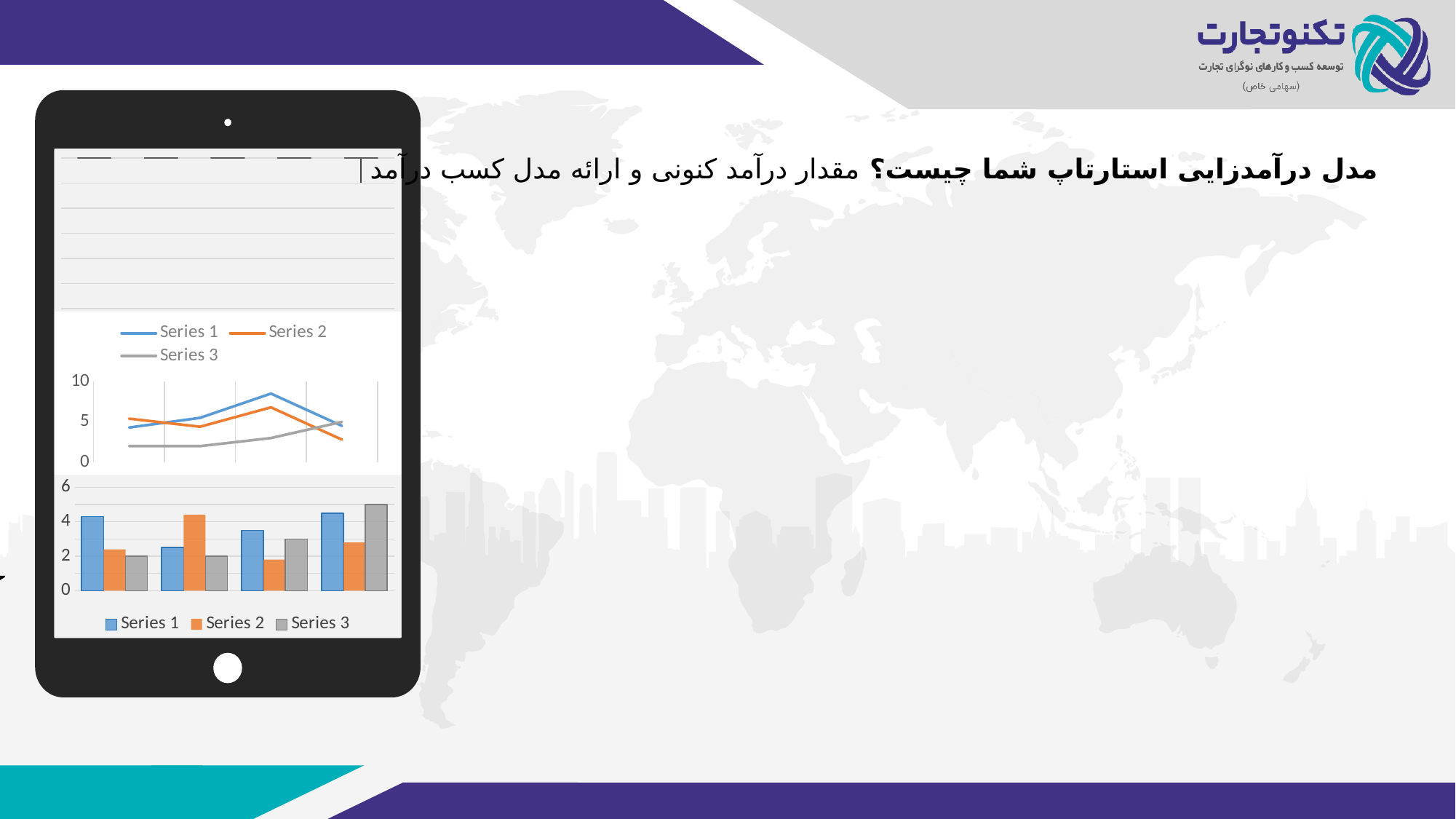
What kind of chart is the bottom chart on the tablet? bar chart In the top line chart, is the highest point of Series 1 greater or less than 5? greater In the bottom bar chart, is the Series 3 bar in the fourth group greater or less than 4? greater How many series does the legend of the bottom bar chart list? 3 What kind of chart is the top chart on the tablet? line chart In the top line chart, does Series 3 generally rise or fall from left to right? rise How many data points does each series have in the top line chart? 4 How many series does the legend of the top line chart list? 3 In the bottom bar chart, in which group is the Series 2 bar the tallest? the second group How many groups of bars are there in the bottom bar chart? 4 In the bottom bar chart, is the Series 2 bar in the third group greater or less than 2? less In the bottom bar chart, which series has the tallest bar in the fourth group? Series 3